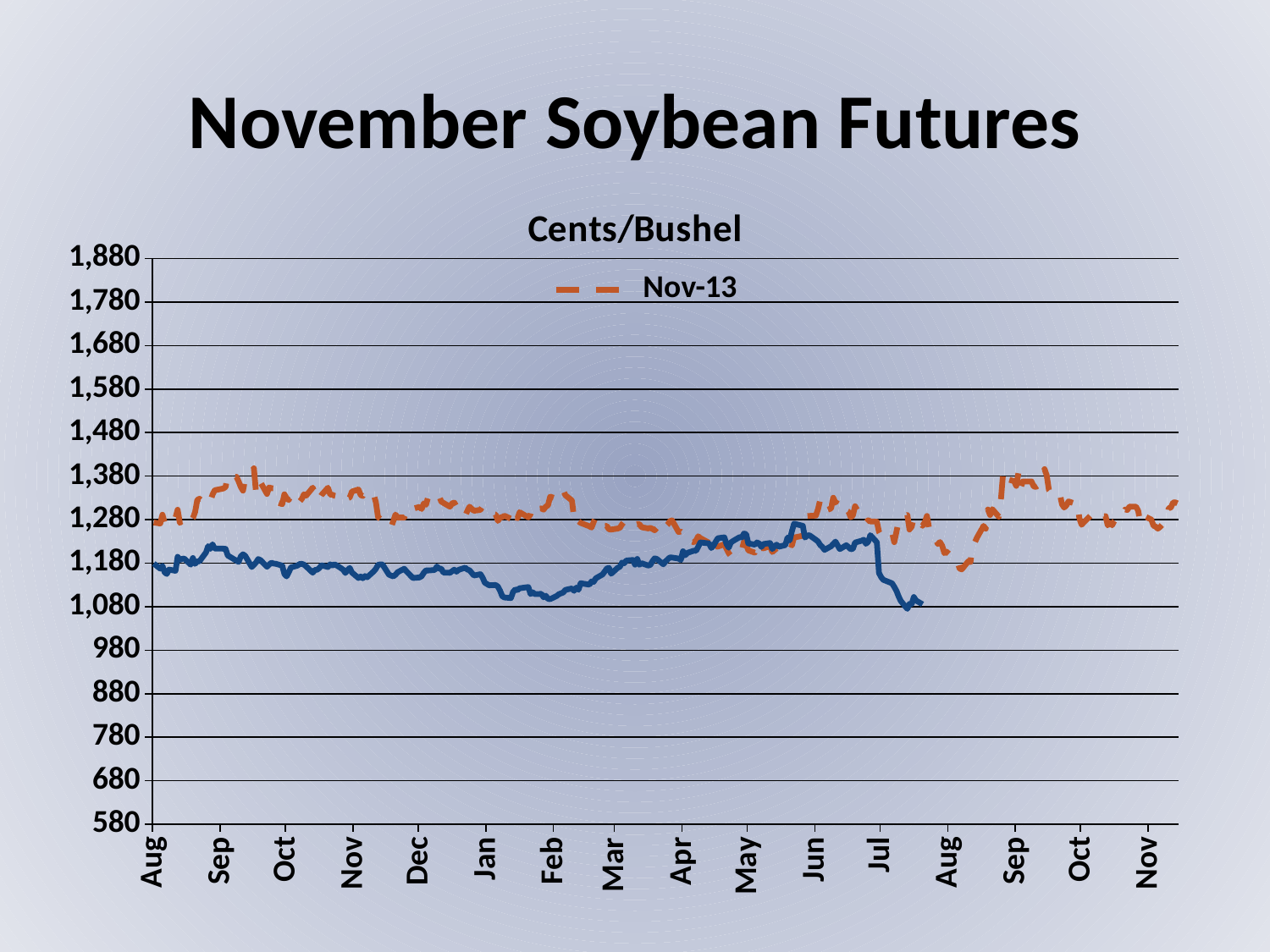
Does the solid blue line rise or fall between Jun and Jul? fall Does the Nov-13 series rise or fall between the second Aug and the second Sep? rise What is the title of the chart? Cents/Bushel What kind of chart is shown on the slide? line chart How many month labels are shown along the x axis? 16 Is the value of the Nov-13 series at the second Aug greater or less than 1,280? less What series name appears in the legend? Nov-13 Is the value of the Nov-13 series at Sep (the first Sep) greater or less than 1,280? greater How many series does the legend list? 1 Which line is higher at Dec, the Nov-13 dashed line or the solid blue line? Nov-13 dashed line Is the value of the solid blue line at Feb greater or less than 1,180? less